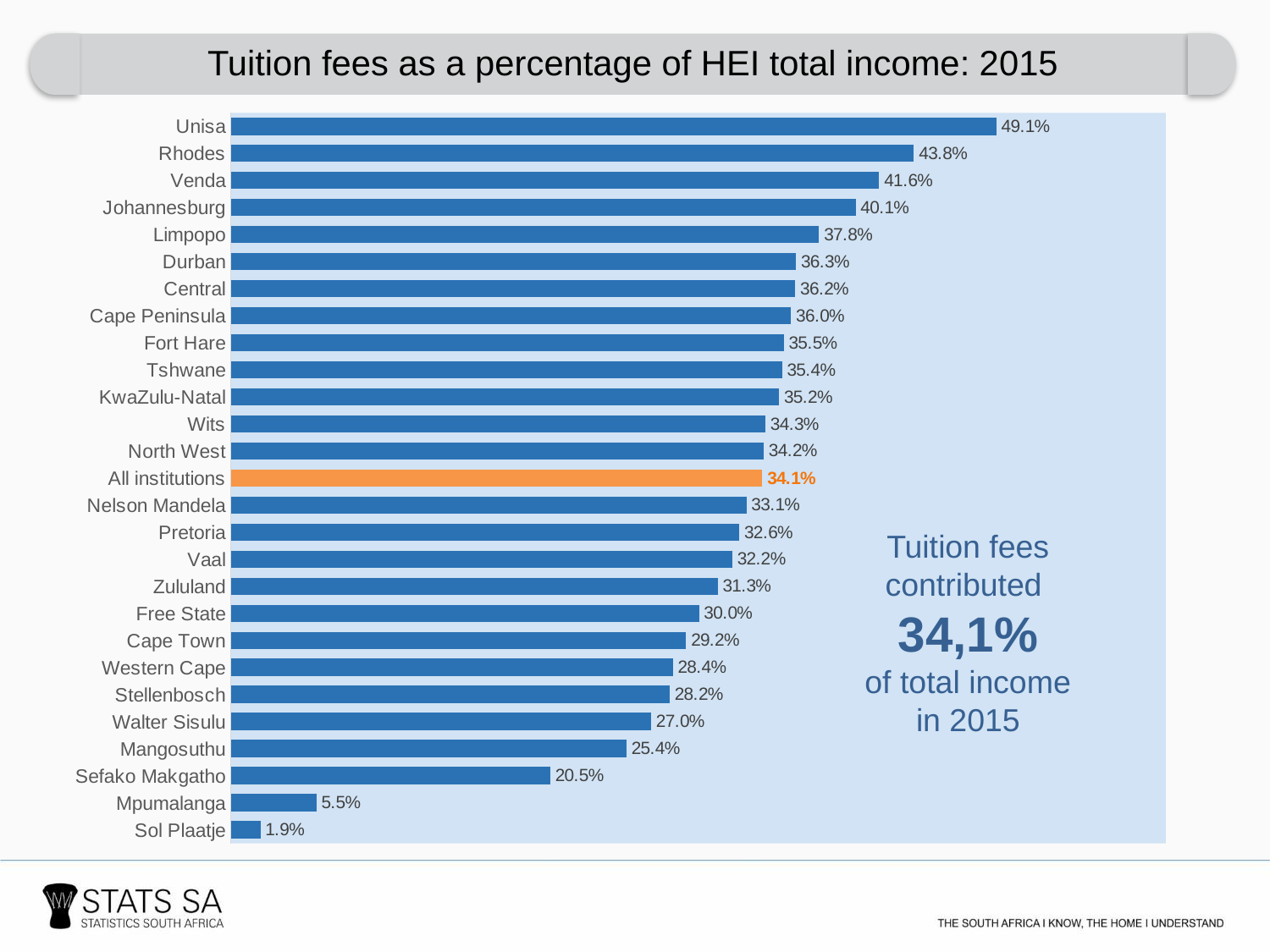
What is the value for All institutions? 34.1% What is the difference between the values for Mpumalanga and Sol Plaatje? 3.6% What is the difference between the values for Rhodes and Venda? 2.2% What is the value for Unisa? 49.1% Which institution has the highest tuition fees as a percentage of total income? Unisa Which has a larger value, Cape Town or Walter Sisulu? Cape Town What kind of chart is shown on the slide? Bar chart What is the value for Sefako Makgatho? 20.5% Which bar is highlighted in orange rather than blue? All institutions How many bars are shown in the chart? 27 Which has a larger value, Limpopo or Pretoria? Limpopo Which institution has the lowest tuition fees as a percentage of total income? Sol Plaatje